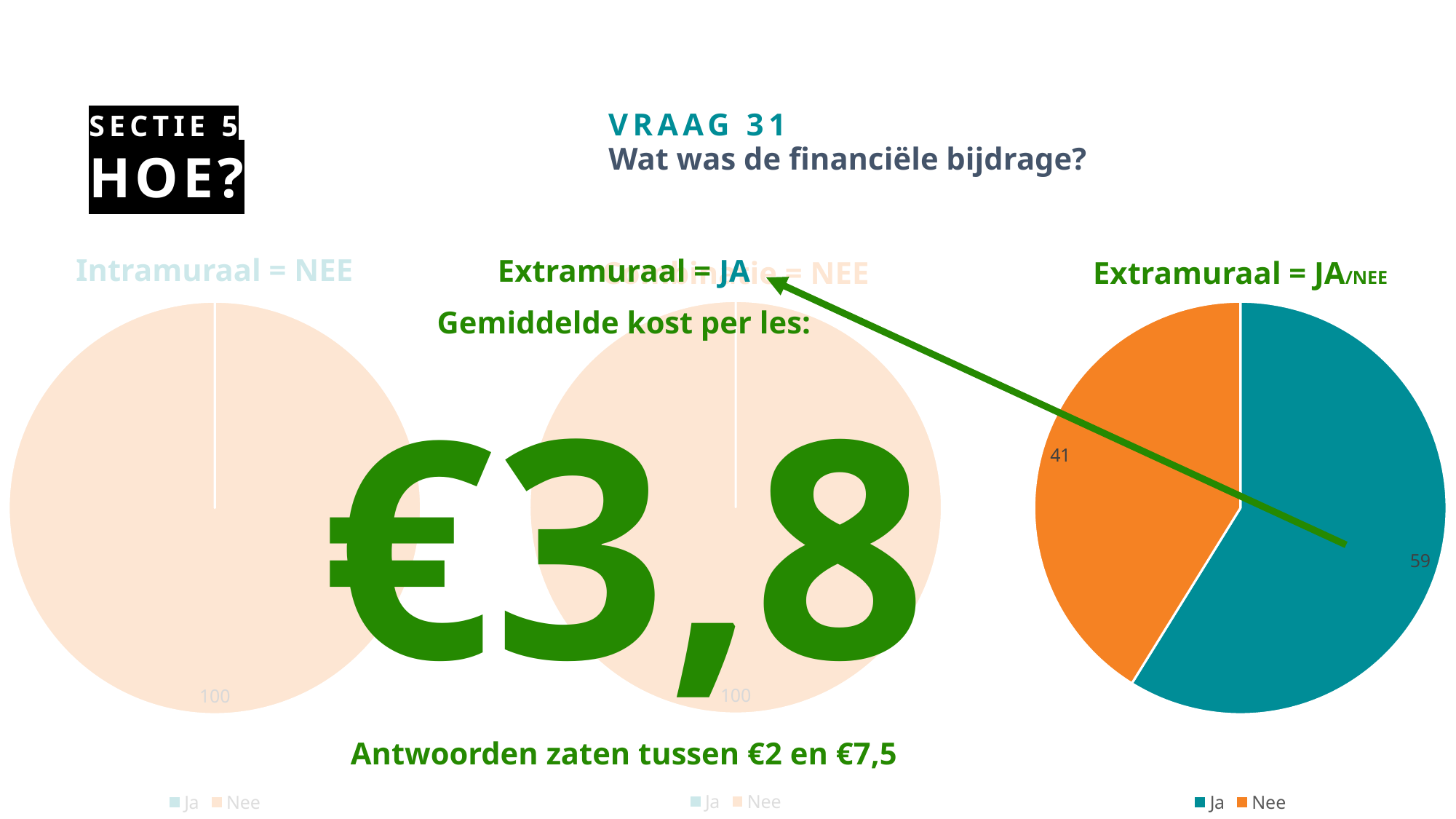
In the 'Extramuraal = JA/NEE' pie chart, what colour is the Nee slice? Orange In the 'Extramuraal = JA/NEE' pie chart, which category has the largest slice? Ja In the 'Extramuraal = JA/NEE' pie chart, which category has the smallest slice? Nee In the 'Intramuraal = NEE' pie chart, what value is shown for Nee? 100 In the 'Extramuraal = JA/NEE' pie chart, what is the difference between the Ja and Nee values? 18 What kind of chart is the 'Extramuraal = JA/NEE' chart? Pie chart How many entries does the legend of the 'Extramuraal = JA/NEE' chart list? 2 In the 'Extramuraal = JA/NEE' pie chart, what colour is the Ja slice? Teal In the 'Extramuraal = JA/NEE' pie chart, what is the value for Nee? 41 In the 'Extramuraal = JA/NEE' pie chart, which slice is larger, Ja or Nee? Ja In the 'Extramuraal = JA/NEE' pie chart, what is the value for Ja? 59 How many pie charts are shown on the slide? 3